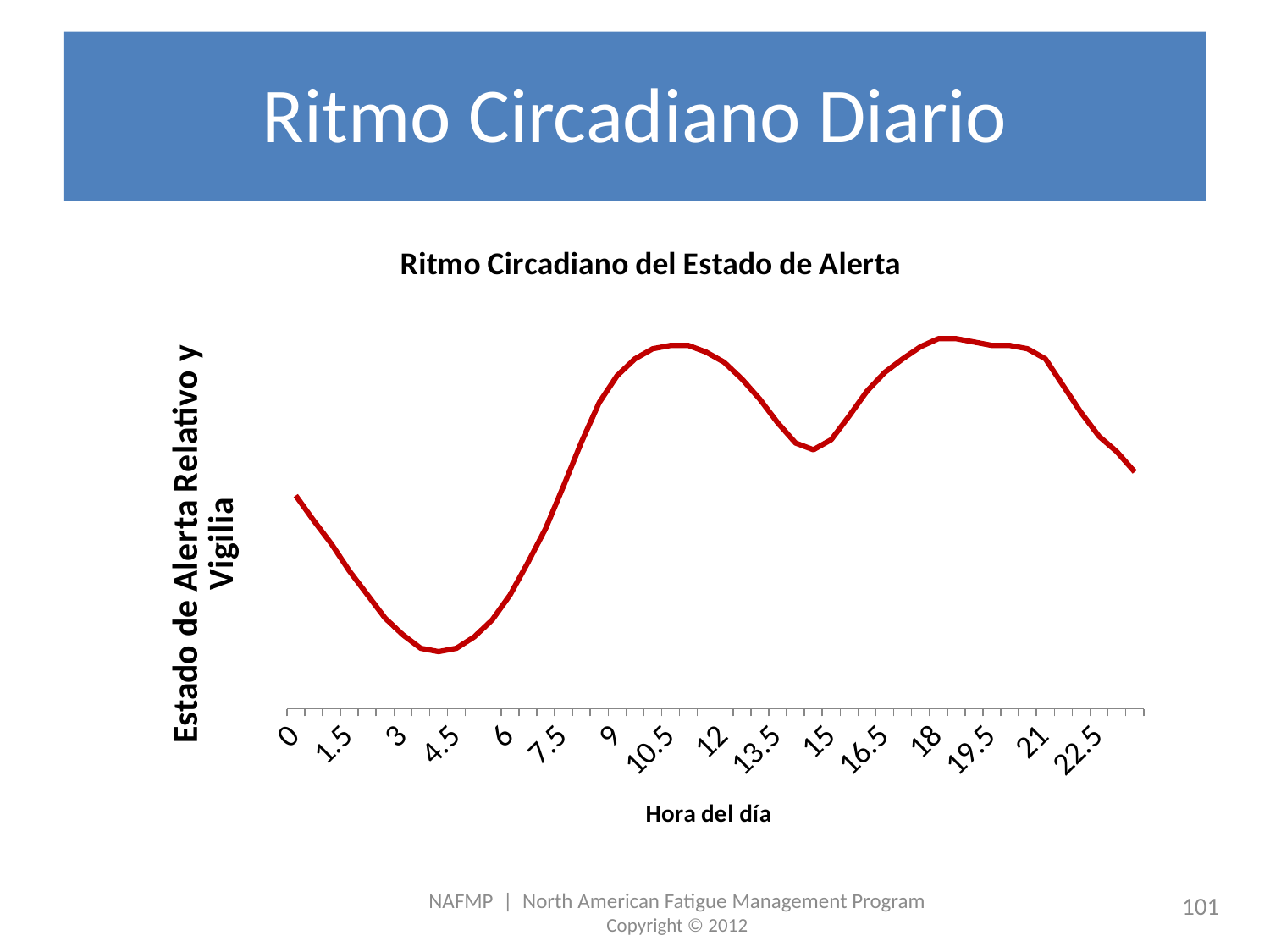
Which has the higher alertness value, hour 15 or hour 18? 18 How many hour labels are shown on the x axis? 16 What kind of chart is shown on the slide? line chart Which has the higher alertness value, hour 3 or hour 9? 9 Does the line rise or fall between hour 0 and hour 4.5? fall Does the line rise or fall between hour 12 and hour 15? fall What is the title of the chart? Ritmo Circadiano del Estado de Alerta Does the line rise or fall between hour 4.5 and hour 10.5? rise Which has the higher alertness value, hour 0 or hour 22.5? 22.5 What is the label of the x axis? Hora del día